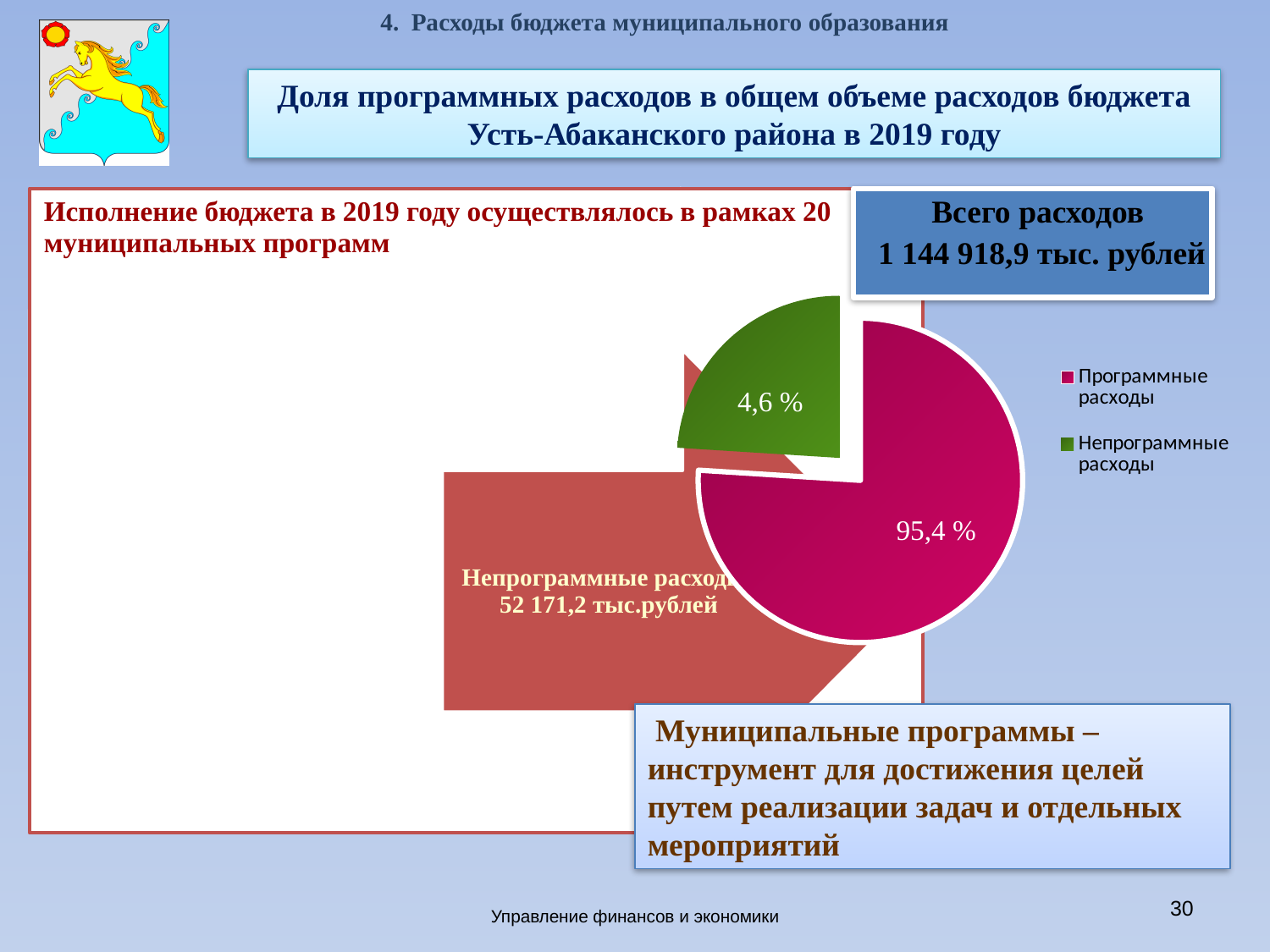
Which slice of the pie chart is the smallest? Непрограммные расходы How many slices does the pie chart have? 2 What share of the pie does "Непрограммные расходы" take? 4,6 % Which slice of the pie chart is the largest? Программные расходы How many entries does the legend of the pie chart list? 2 What kind of chart is shown on the slide? pie chart By how many percentage points does the share of "Программные расходы" exceed the share of "Непрограммные расходы"? 90,8 What colour is the "Непрограммные расходы" slice in the pie chart? green What share of the pie does "Программные расходы" take? 95,4 % Which is larger in the pie chart: "Программные расходы" or "Непрограммные расходы"? Программные расходы What colour is the "Программные расходы" slice in the pie chart? magenta (crimson)